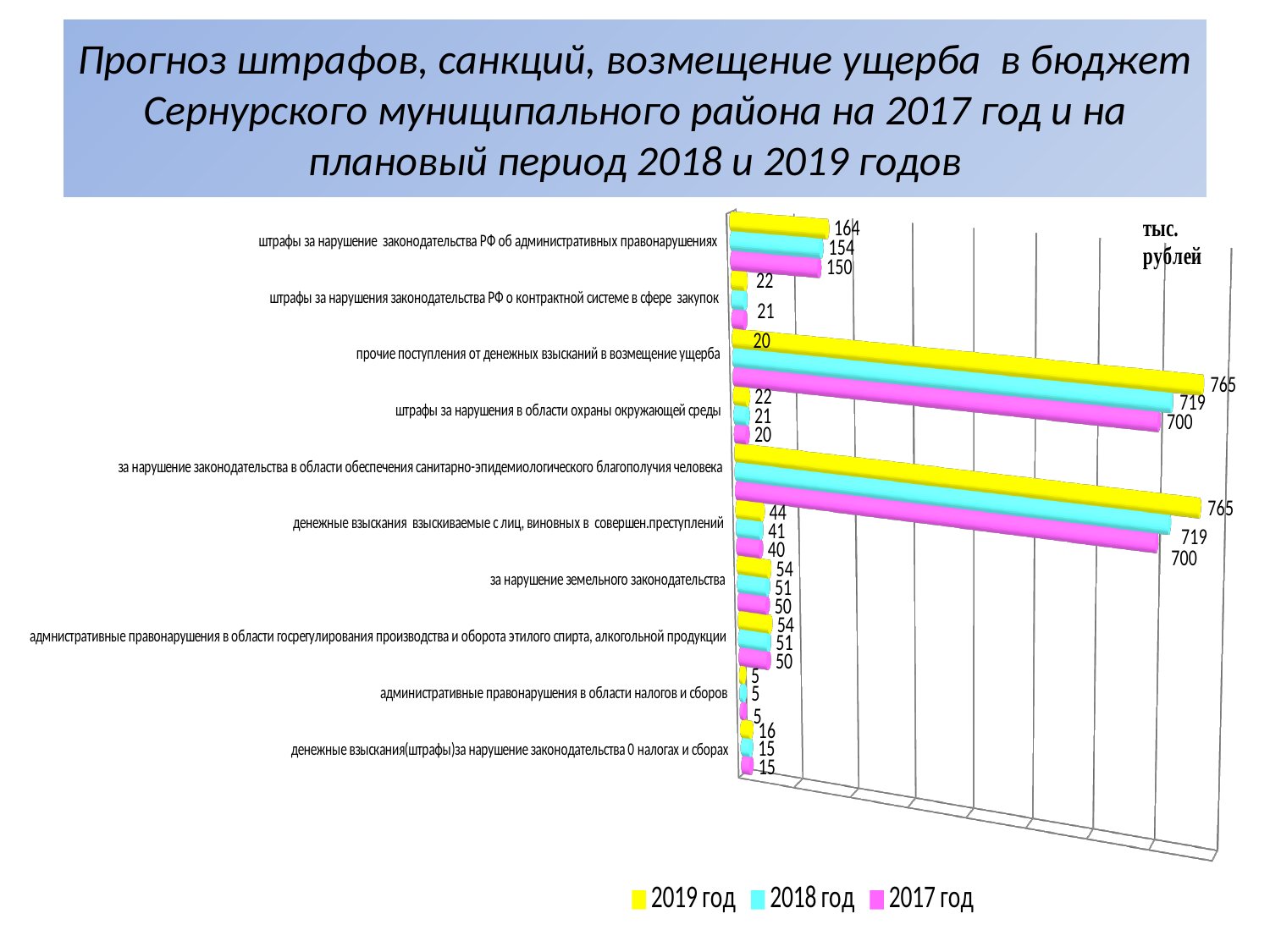
What is the difference between the 2019 год and 2017 год values for 'штрафы за нарушение законодательства РФ об административных правонарушениях'? 14 Which is larger for 2019 год: 'штрафы за нарушение законодательства РФ об административных правонарушениях' or 'денежные взыскания(штрафы)за нарушение законодательства 0 налогах и сборах'? штрафы за нарушение законодательства РФ об административных правонарушениях What kind of chart is shown on the slide? bar chart Which category has the lowest values across all three years? административные правонарушения в области налогов и сборов How many series does the legend list? 3 What is the value for 2019 год for 'штрафы за нарушение законодательства РФ об административных правонарушениях'? 164 How many categories are plotted on the chart? 10 What is the value for 2018 год for 'штрафы за нарушение законодательства РФ об административных правонарушениях'? 154 What unit is indicated in the top-right corner of the chart? тыс. рублей What is the value for 2017 год for 'штрафы за нарушение законодательства РФ об административных правонарушениях'? 150 What is the value for 2017 год for 'административные правонарушения в области налогов и сборов'? 5 What is the value for 2019 год for 'денежные взыскания(штрафы)за нарушение законодательства 0 налогах и сборах'? 16